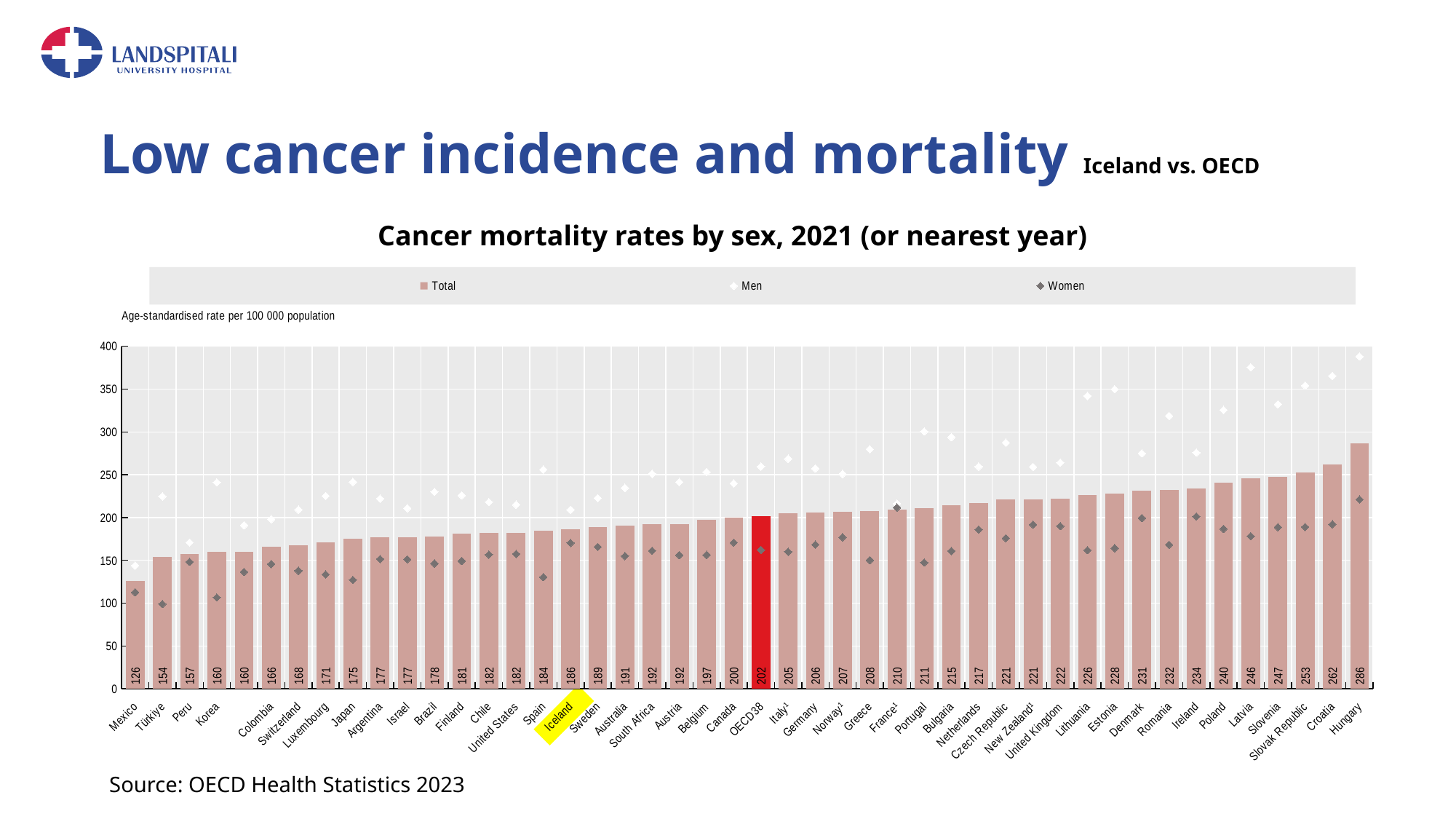
What is the total cancer mortality rate shown for Canada? 200 Is the Women value for Mexico greater or less than 150? less What kind of chart is used to show the total cancer mortality rates? Bar chart What is the total cancer mortality rate shown for OECD38? 202 What is the total cancer mortality rate shown for Iceland? 186 Is the Men value for Hungary greater or less than 350? greater Which country has the lowest total cancer mortality rate on the chart? Mexico How many series does the legend list? 3 Which country has the highest total cancer mortality rate on the chart? Hungary Which has the higher total cancer mortality rate, Iceland or Sweden? Sweden Which bar is coloured red on the chart? OECD38 How much higher is the OECD38 total rate than Iceland's total rate? 16